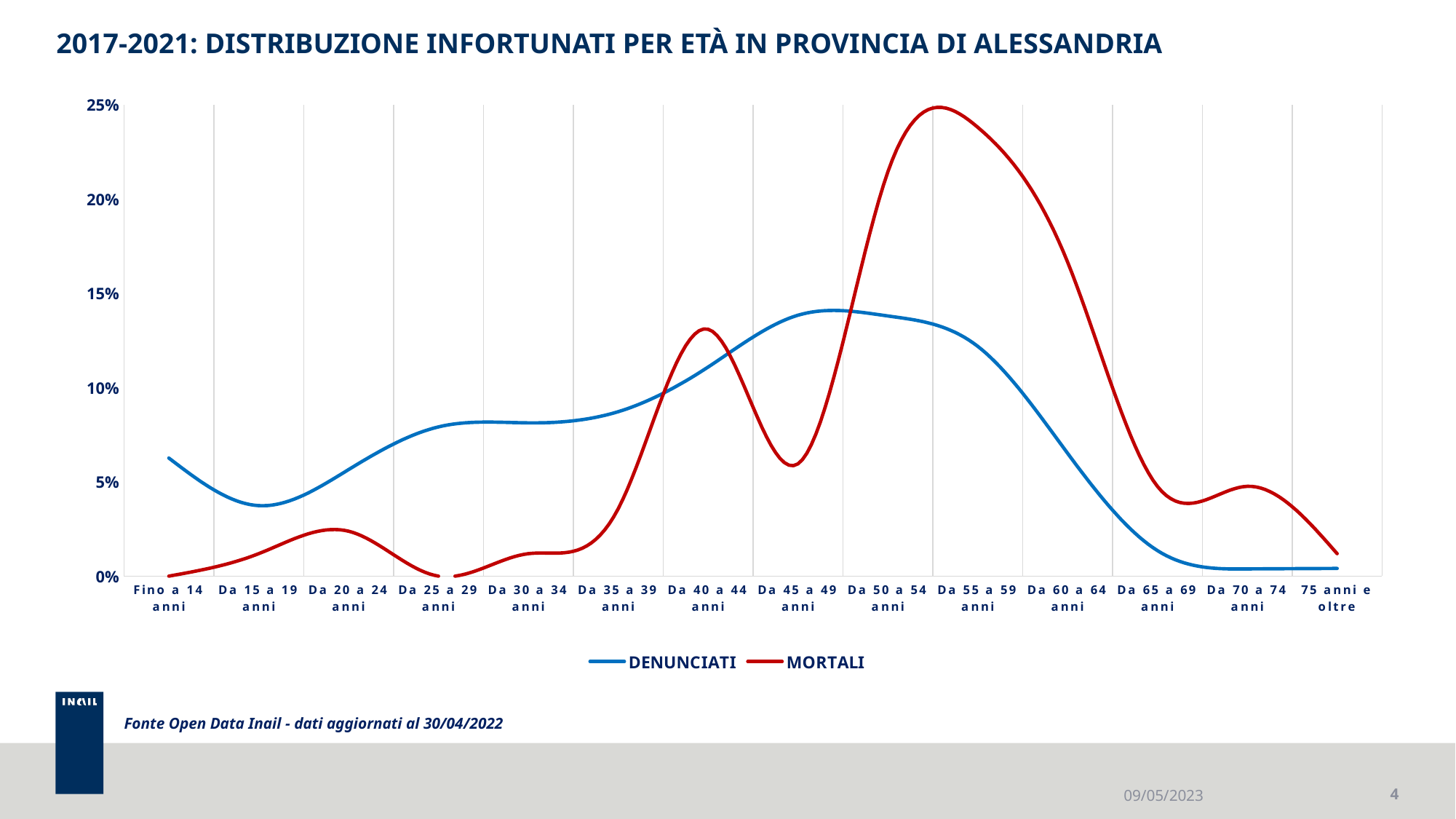
At Da 30 a 34 anni, which series has the larger value, DENUNCIATI or MORTALI? DENUNCIATI How many age categories are shown on the x axis? 14 Is the value for MORTALI at Da 55 a 59 anni greater or less than 20%? greater Does the DENUNCIATI line rise or fall from Da 50 a 54 anni to Da 70 a 74 anni? Fall Is the value for DENUNCIATI at Da 15 a 19 anni greater or less than 5%? less Which age category has the highest value for MORTALI? Da 55 a 59 anni At Da 55 a 59 anni, which series has the larger value, DENUNCIATI or MORTALI? MORTALI Which colour is used for the MORTALI series? Red Is the value for MORTALI at Da 40 a 44 anni greater or less than 10%? greater What kind of chart is shown on the slide? Line chart How many series does the legend list? 2